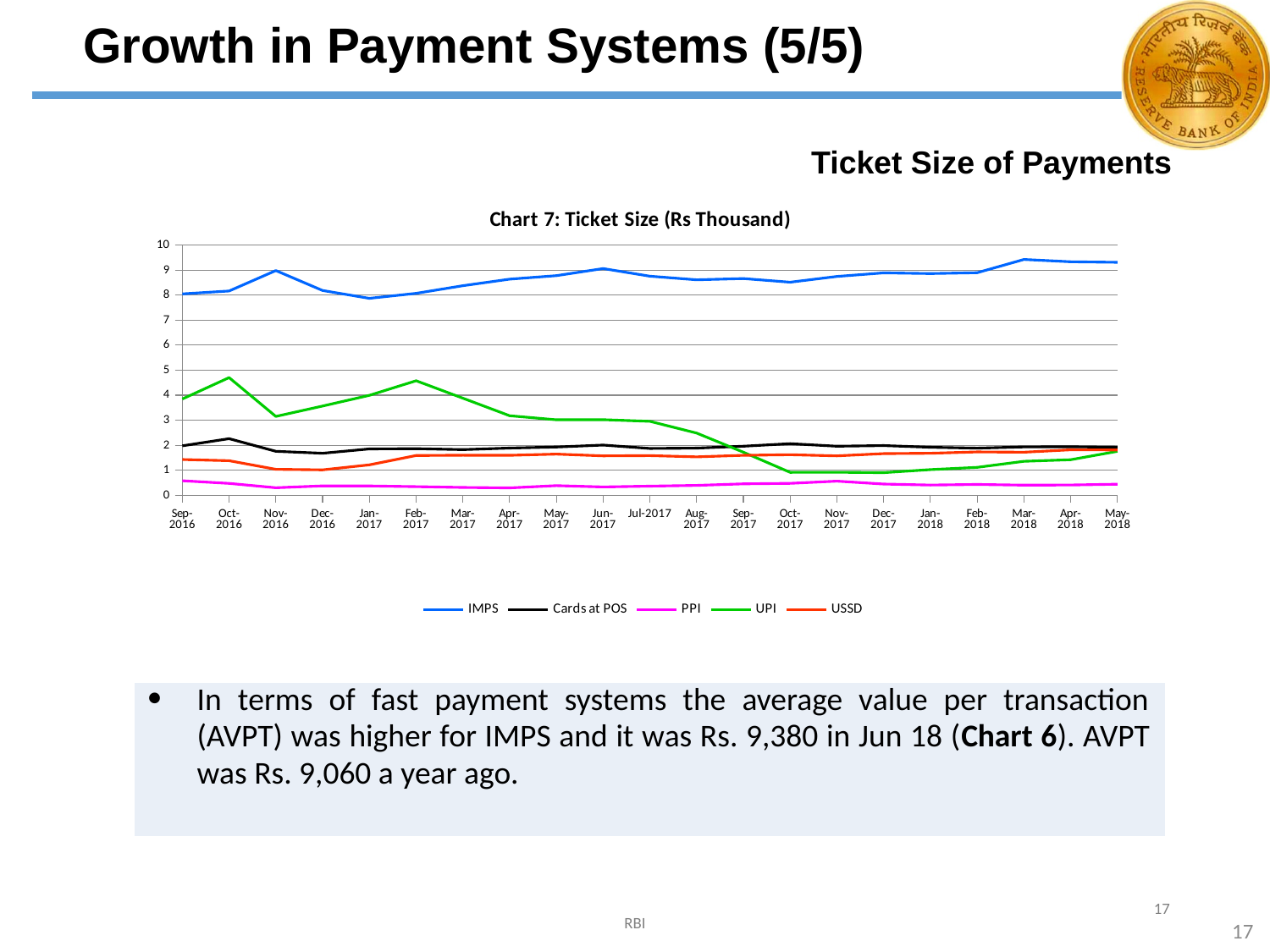
Is the value for IMPS in Nov-2016 greater or less than 8? greater Which series in Chart 7 has the highest values across the whole period? IMPS Which series in Chart 7 has the lowest values across the whole period? PPI Is the value for PPI in Sep-2016 greater or less than 1? less How many series does the legend of Chart 7 list? 5 Is the value for UPI in Oct-2016 greater or less than 4? greater In Oct-2017, which is larger in Chart 7: UPI or USSD? USSD What kind of chart is Chart 7: Ticket Size (Rs Thousand)? line chart Does the UPI line in Chart 7 rise or fall between Feb-2017 and Oct-2017? fall What is the title of the chart on the slide? Chart 7: Ticket Size (Rs Thousand) How many months are plotted along the x axis of Chart 7? 21